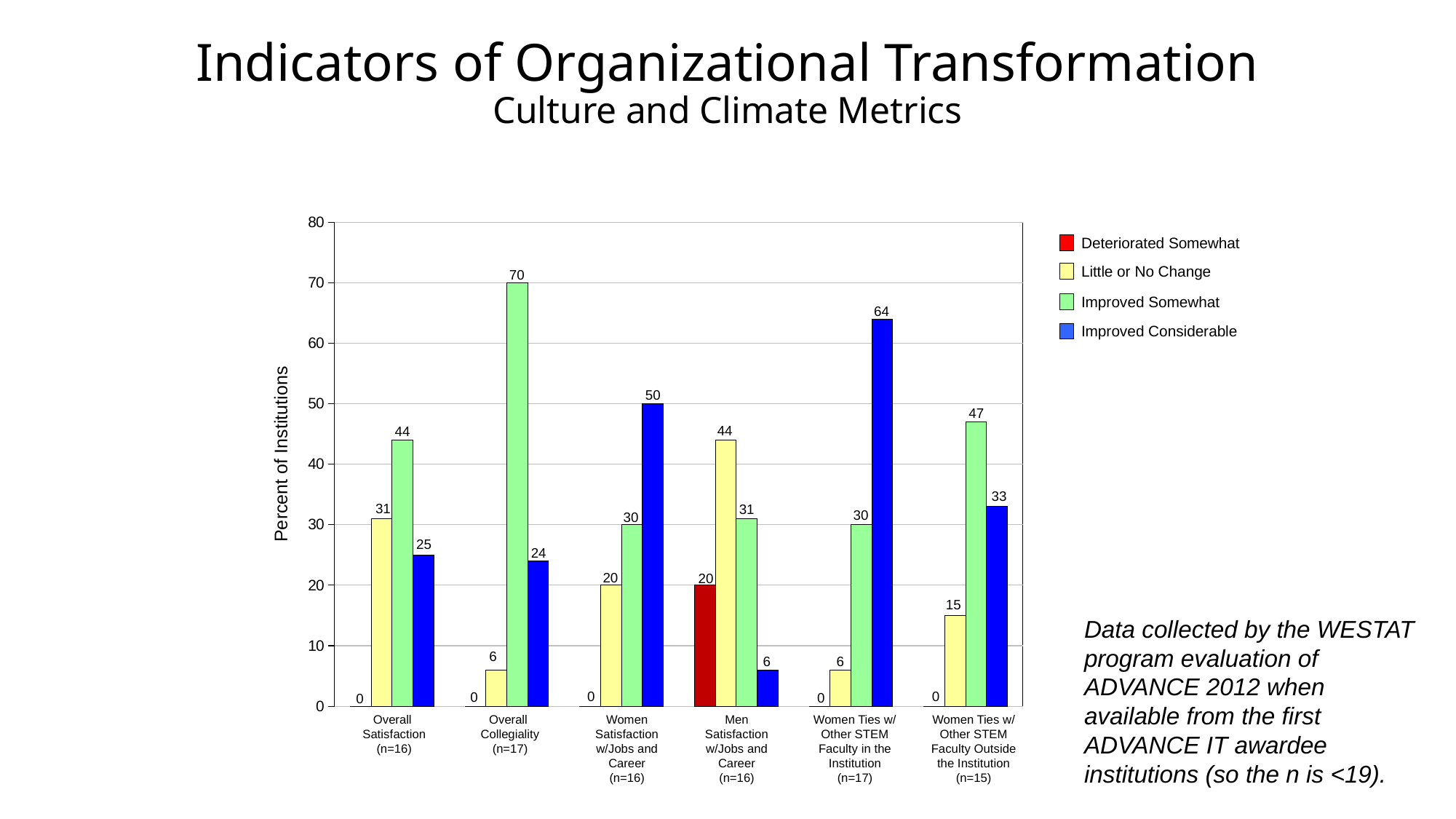
Which is larger in the Women Satisfaction w/Jobs and Career category: Improved Somewhat or Improved Considerable? Improved Considerable What is the value for Deteriorated Somewhat in the Men Satisfaction w/Jobs and Career category? 20 What is the label of the y axis? Percent of Institutions What is the difference between the Improved Somewhat and Improved Considerable values in the Overall Collegiality category? 46 Which category has the lowest value for Improved Considerable? Men Satisfaction w/Jobs and Career What is the value for Little or No Change in the Women Ties w/ Other STEM Faculty Outside the Institution category? 15 What is the value for Improved Somewhat in the Overall Collegiality category? 70 How many categories are shown on the x axis? 6 Which category has the highest value for Improved Considerable? Women Ties w/ Other STEM Faculty in the Institution What is the value for Improved Considerable in the Women Ties w/ Other STEM Faculty in the Institution category? 64 What kind of chart is shown on the slide? Bar chart How many series does the legend list? 4